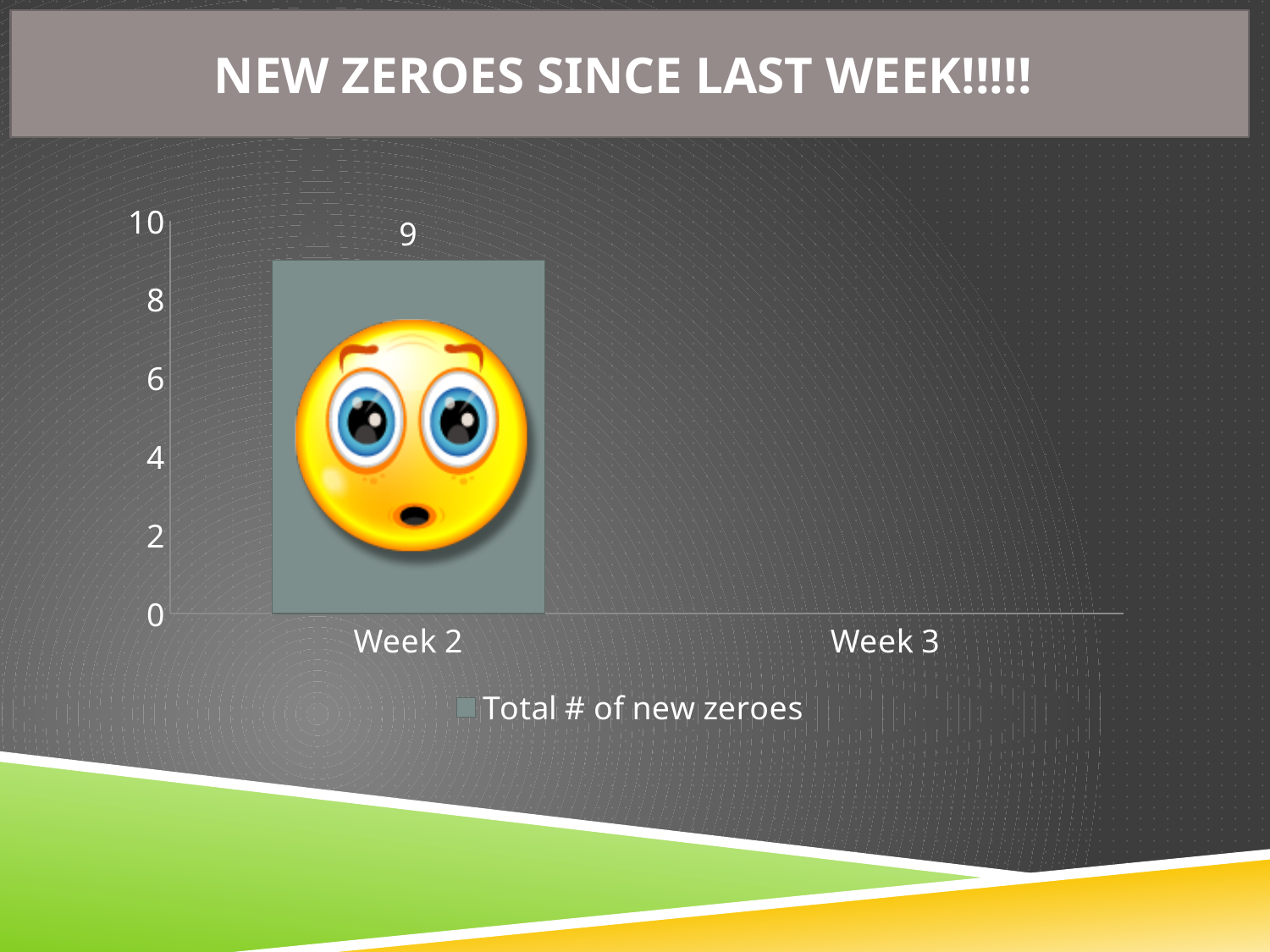
Is the value for Week 2 greater or less than 10? less What is the title of the slide? NEW ZEROES SINCE LAST WEEK!!!!! How many series does the legend list? 1 What is the maximum value shown on the vertical axis? 10 How many categories are shown on the x axis? 2 Which week has the highest value? Week 2 What is the value for Week 2? 9 What kind of chart is shown on the slide? bar chart Is the value for Week 2 greater or less than 6? greater What is the name of the series in the legend? Total # of new zeroes